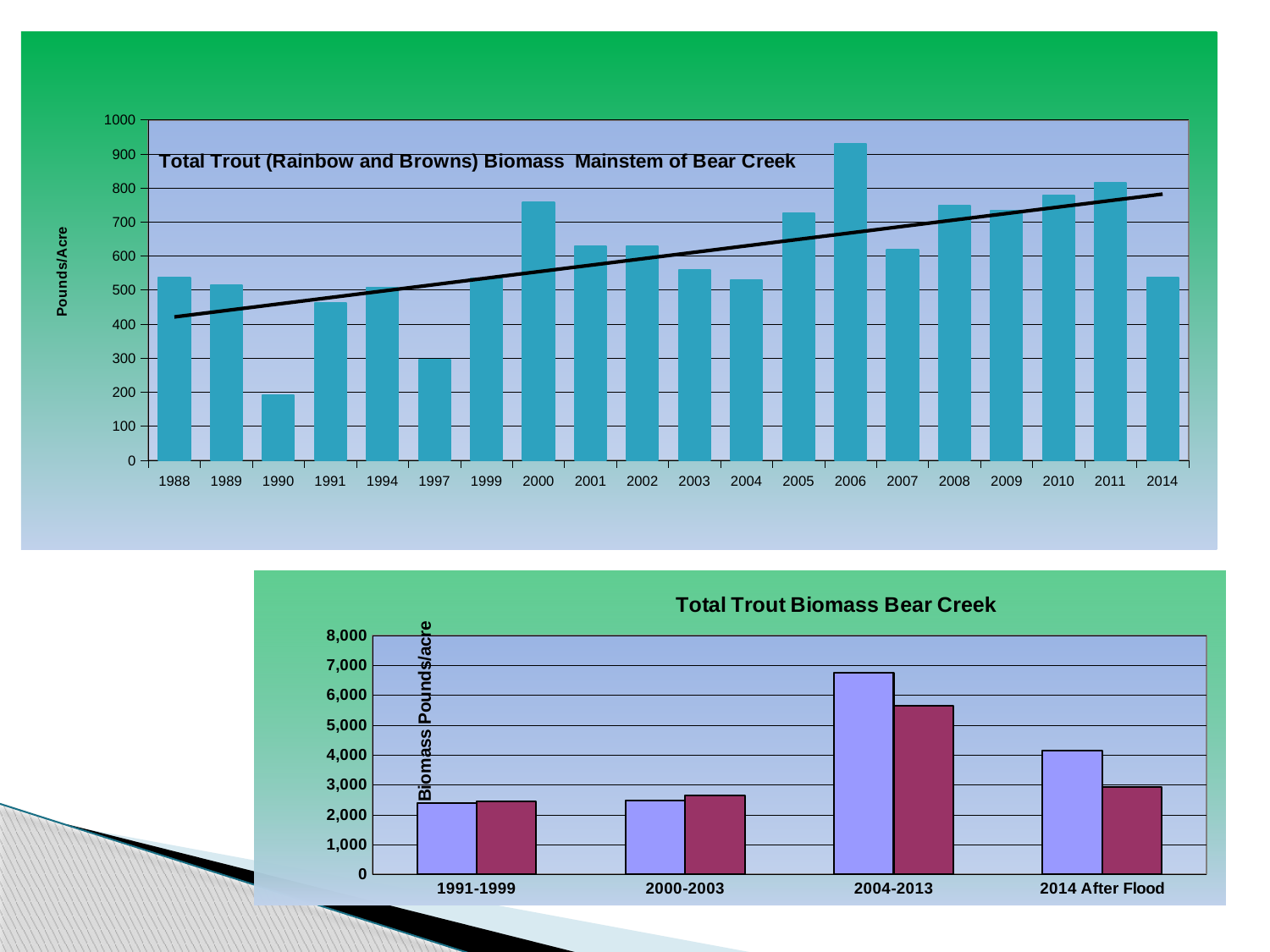
In the top chart, Total Trout (Rainbow and Browns) Biomass Mainstem of Bear Creek, does the trend line rise or fall from 1988 to 2014? Rises In the top chart, Total Trout (Rainbow and Browns) Biomass Mainstem of Bear Creek, which year has the larger value, 2000 or 2003? 2000 In the top chart, Total Trout (Rainbow and Browns) Biomass Mainstem of Bear Creek, is the value for 2006 greater or less than 900? greater In the bottom chart, Total Trout Biomass Bear Creek, which period has the tallest bar? 2004-2013 In the top chart, Total Trout (Rainbow and Browns) Biomass Mainstem of Bear Creek, which year has the lowest biomass? 1990 In the top chart, Total Trout (Rainbow and Browns) Biomass Mainstem of Bear Creek, which year has the highest biomass? 2006 In the bottom chart, Total Trout Biomass Bear Creek, how many period categories are shown on the x axis? 4 In the bottom chart, Total Trout Biomass Bear Creek, is the value of the left (light purple) bar for 2004-2013 greater or less than 6,000? greater In the top chart, what is the label on the vertical axis? Pounds/Acre In the top chart, Total Trout (Rainbow and Browns) Biomass Mainstem of Bear Creek, how many years are shown on the x axis? 20 In the top chart, Total Trout (Rainbow and Browns) Biomass Mainstem of Bear Creek, is the value for 1997 greater or less than 400? less In the top chart, Total Trout (Rainbow and Browns) Biomass Mainstem of Bear Creek, what kind of chart is used? Bar chart